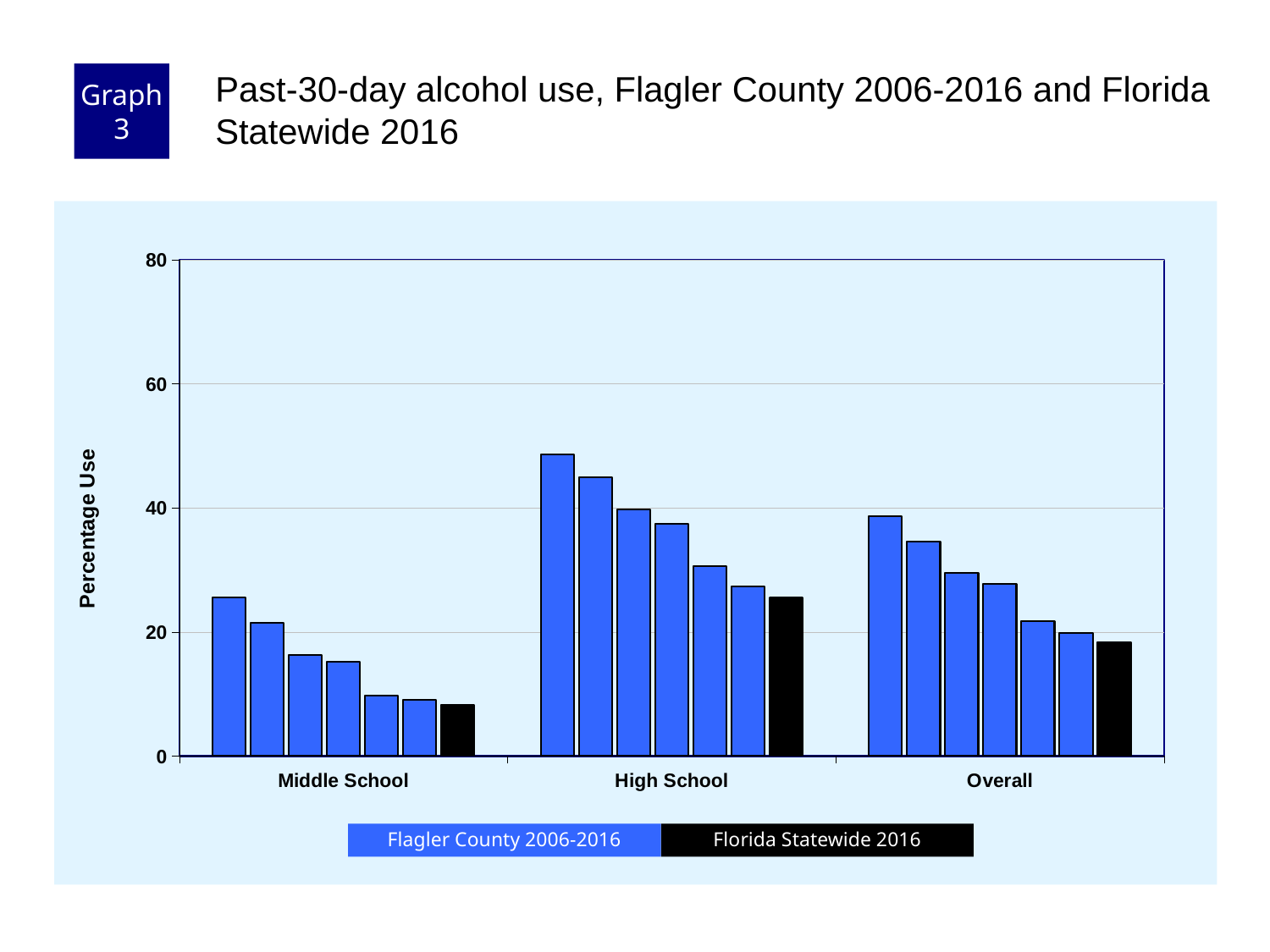
How many series does the legend list? 2 Which category has the highest Florida Statewide 2016 value? High School Is the Florida Statewide 2016 value for High School greater or less than 20? greater Is the tallest Flagler County bar in the High School group greater or less than 40? greater Within the High School group, do the Flagler County 2006-2016 bars rise or fall from left to right? fall What kind of chart is shown on the slide? bar chart How many school-level categories are shown on the x axis? 3 Which series is shown in black? Florida Statewide 2016 Which category has the lowest Florida Statewide 2016 value? Middle School Is the tallest Flagler County bar in the Middle School group greater or less than 20? greater What is the label of the y axis? Percentage Use